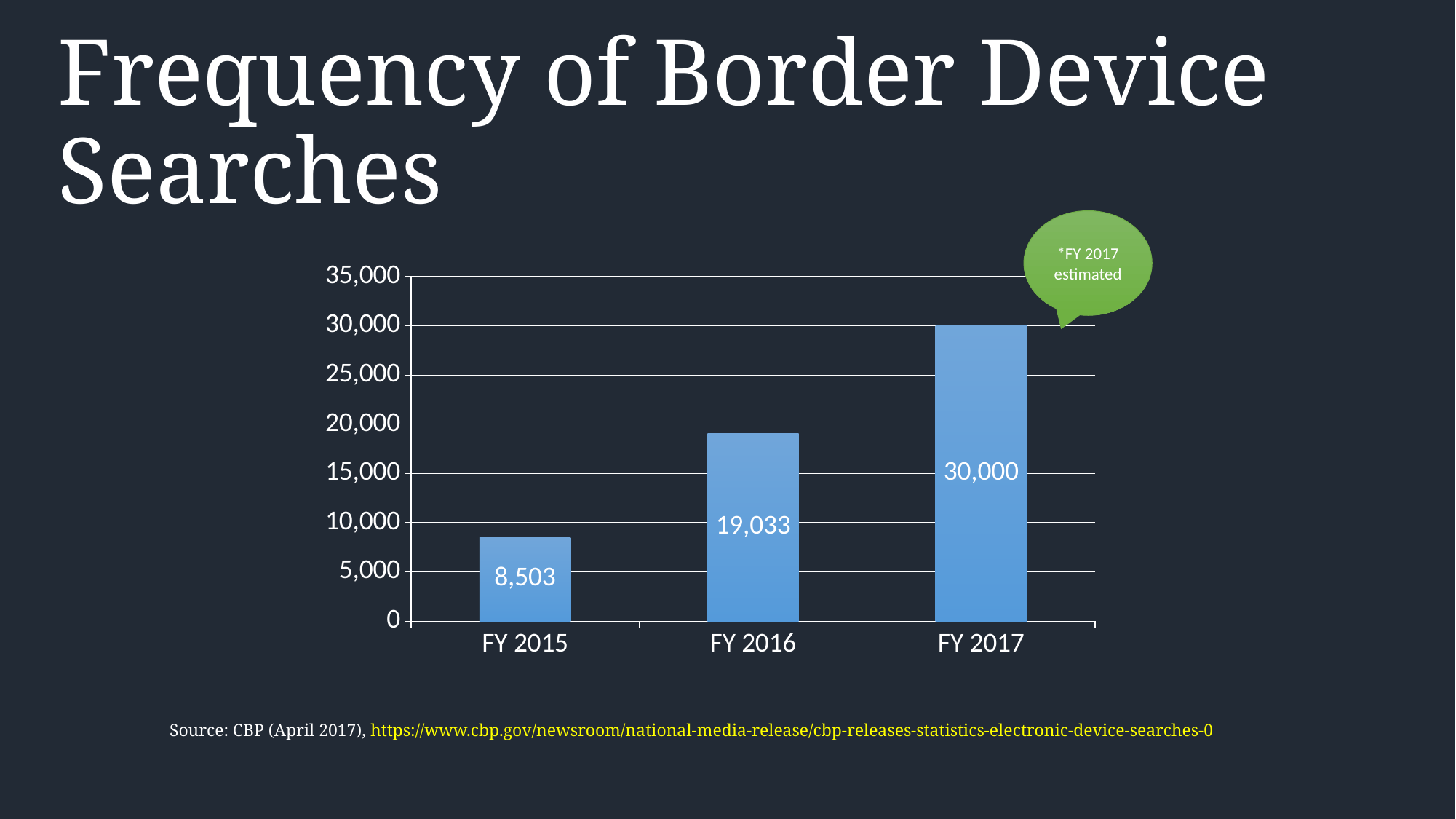
Which fiscal year has the highest value? FY 2017 What is the difference between the FY 2017 and FY 2016 values? 10,967 Is the value for FY 2016 greater or less than 20,000? less Do the values rise or fall from FY 2015 to FY 2017? rise What is the difference between the FY 2016 and FY 2015 values? 10,530 Which is larger, the value for FY 2015 or FY 2016? FY 2016 What is the value for FY 2015? 8,503 What is the value for FY 2017? 30,000 How many fiscal years are shown on the chart? 3 Which fiscal year has the lowest value? FY 2015 What kind of chart is shown on the slide? bar chart What is the value for FY 2016? 19,033